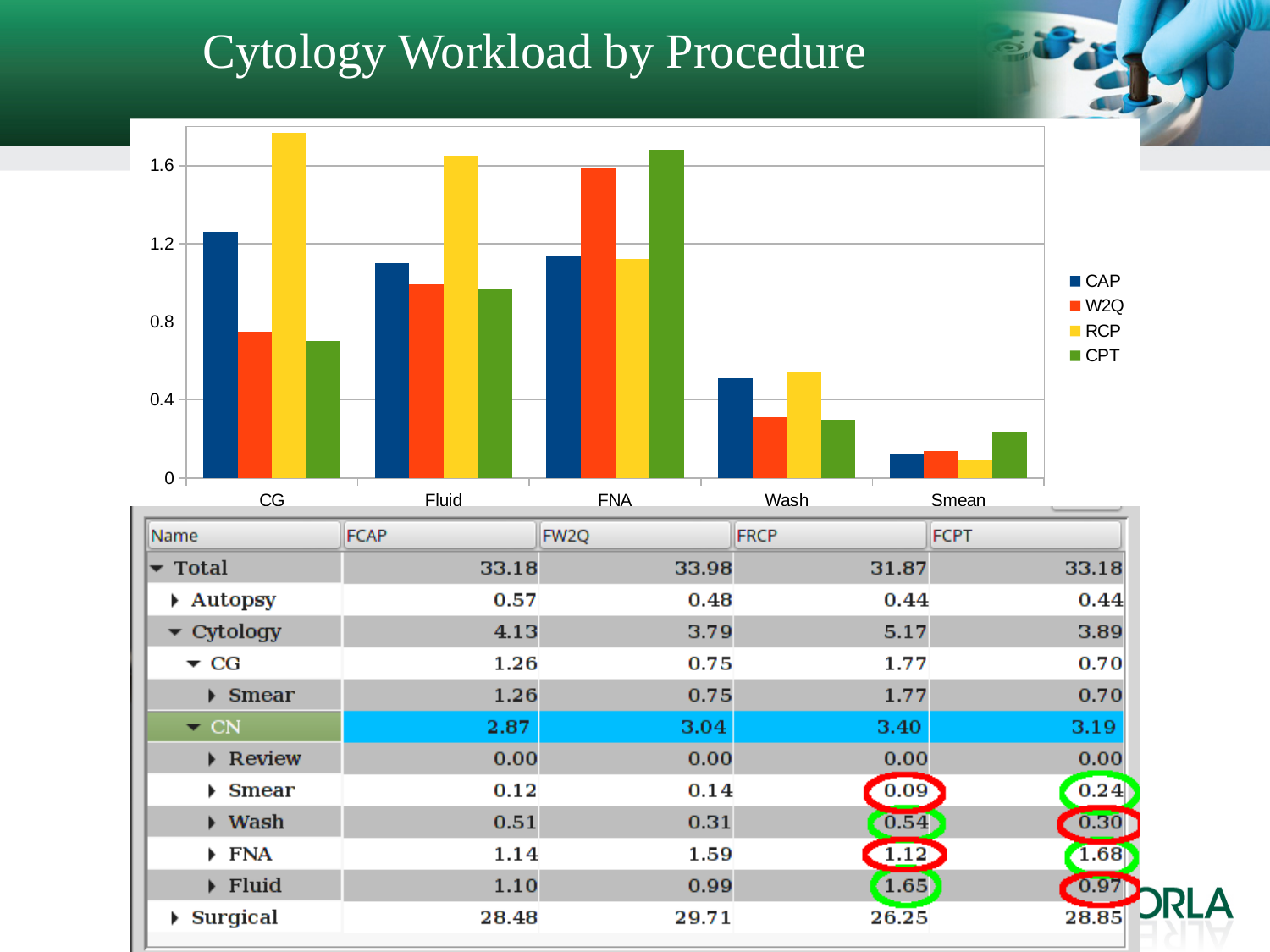
According to the table below the chart, what is the RCP value for CG? 1.77 What colour represents the RCP series in the chart legend? yellow What is the title of the slide containing the chart? Cytology Workload by Procedure Is the W2Q value for FNA greater or less than 1.2? greater How many procedure categories are shown on the x axis of the chart? 5 For CG, which is larger, the RCP bar or the CAP bar? RCP What kind of chart is shown on the slide? bar chart Which category has the tallest RCP bar? CG Which category has the shortest CPT bar? Smean How many series does the chart legend list? 4 Using the table values, what is the difference between the CPT and RCP values for FNA? 0.56 Is the CPT value for Wash greater or less than 0.4? less